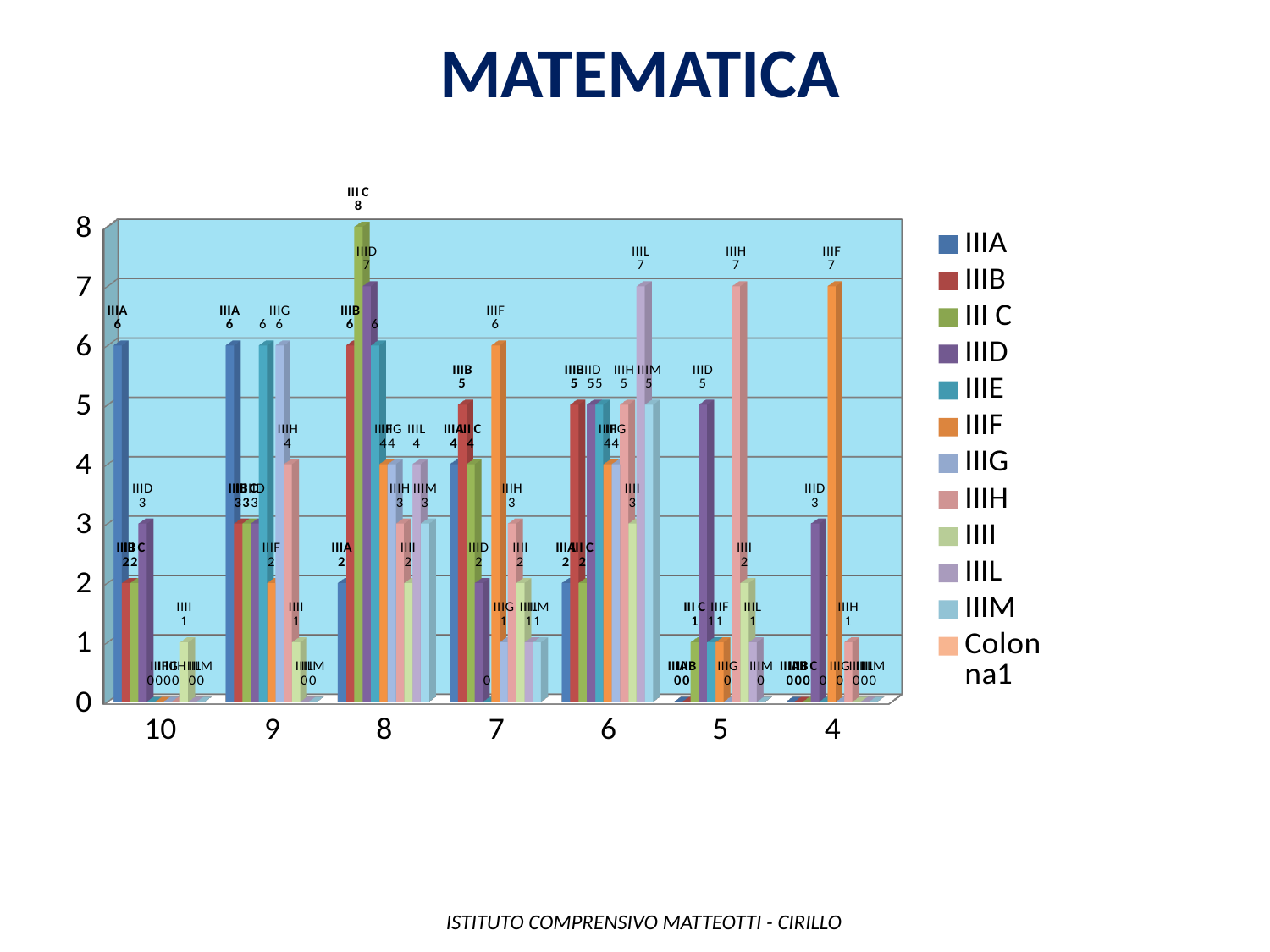
Which is larger in category 10, IIIA or IIID? IIIA What is the title of the chart? MATEMATICA How many categories are shown along the x axis? 7 What is the difference between III C and IIID in category 8? 1 What is the value for III C in category 8? 8 What is the value for IIIH in category 5? 7 What is the value for IIIA in category 10? 6 How many series does the legend list? 12 What is the value for IIIF in category 4? 7 What kind of chart is shown on the slide? bar chart Which series has the highest bar in category 8? III C What is the last entry listed in the legend? Colonna1